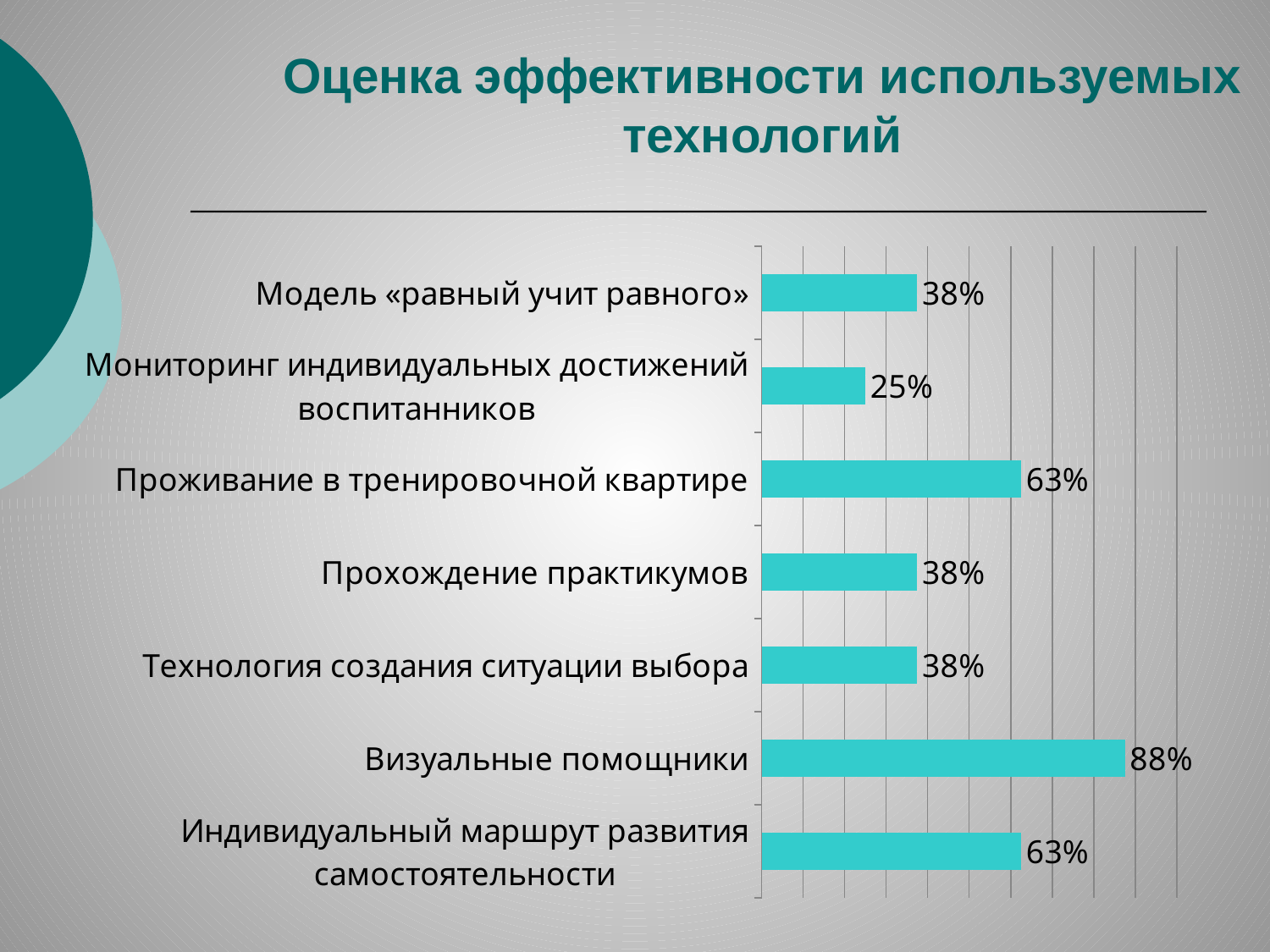
What is the value for «Проживание в тренировочной квартире»? 63% Which is larger: the value for «Индивидуальный маршрут развития самостоятельности» or the value for «Технология создания ситуации выбора»? Индивидуальный маршрут развития самостоятельности Which category has the highest value? Визуальные помощники What is the difference between the values for «Визуальные помощники» and «Мониторинг индивидуальных достижений воспитанников»? 63% What is the difference between the values for «Проживание в тренировочной квартире» and «Прохождение практикумов»? 25% What is the value for «Мониторинг индивидуальных достижений воспитанников»? 25% What kind of chart is shown on the slide? Bar chart Which category has the lowest value? Мониторинг индивидуальных достижений воспитанников What is the title of the slide? Оценка эффективности используемых технологий How many categories are shown in the chart? 7 What is the value for «Визуальные помощники»? 88% What is the value for «Модель «равный учит равного»»? 38%